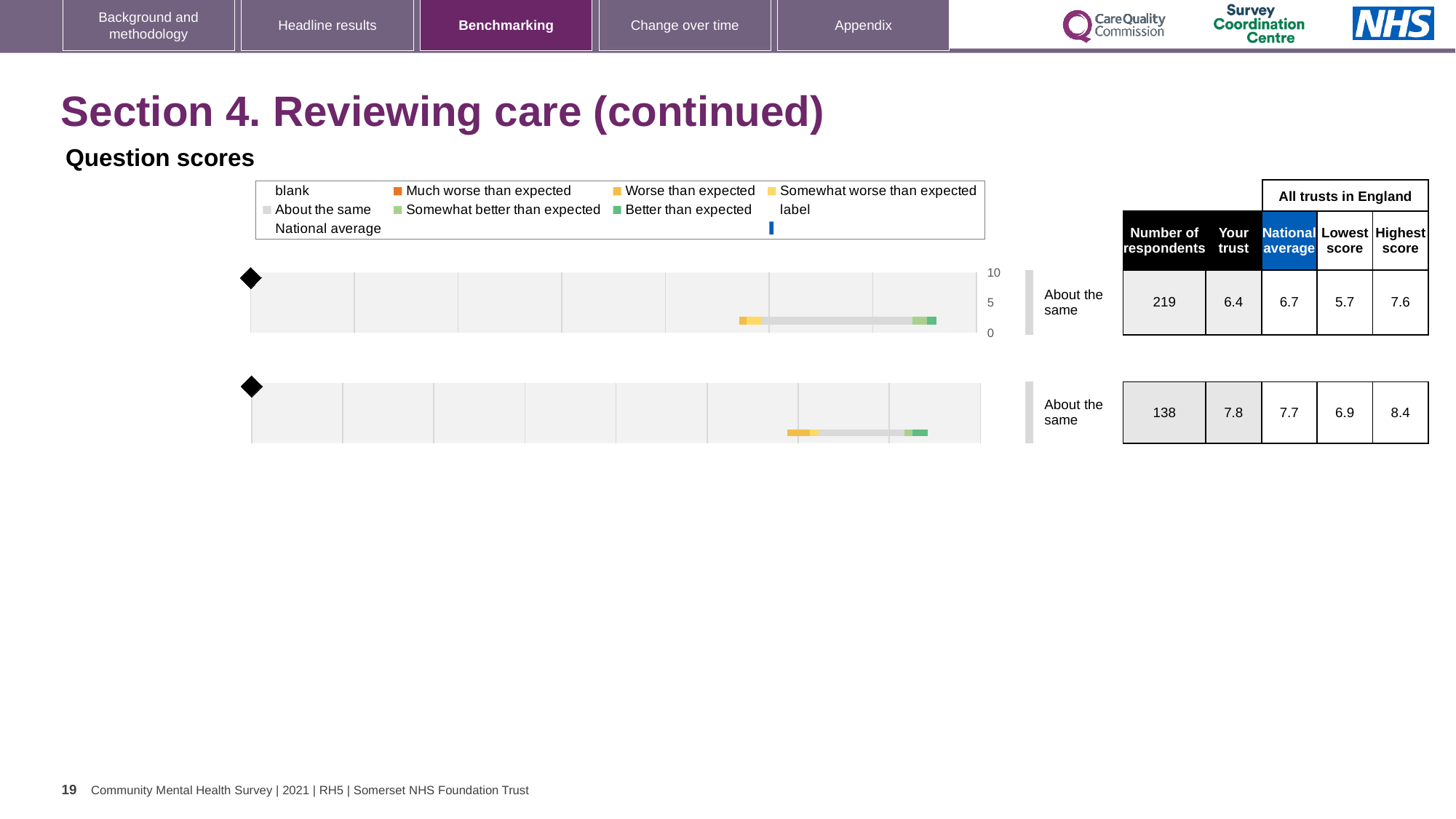
For the top chart, which is larger: the 'Your trust' score or the national average? National average For the bottom chart, what is the 'Your trust' score shown in the table? 7.8 For the top chart, what is the national average score shown in the table? 6.7 For the top chart, what is the difference between the highest score (7.6) and the lowest score (5.7) among all trusts in England? 1.9 What benchmark category label is shown next to both charts? About the same How many question score charts are shown on the slide? 2 For the top chart, what is the 'Your trust' score shown in the table? 6.4 For the bottom chart, what is the highest score among all trusts in England? 8.4 For the bottom chart, what is the difference between the highest score (8.4) and the lowest score (6.9) among all trusts in England? 1.5 For the bottom chart, which is larger: the 'Your trust' score or the national average? Your trust For the top chart, how many respondents are listed? 219 What kind of chart is used for the question scores on this slide? bar chart